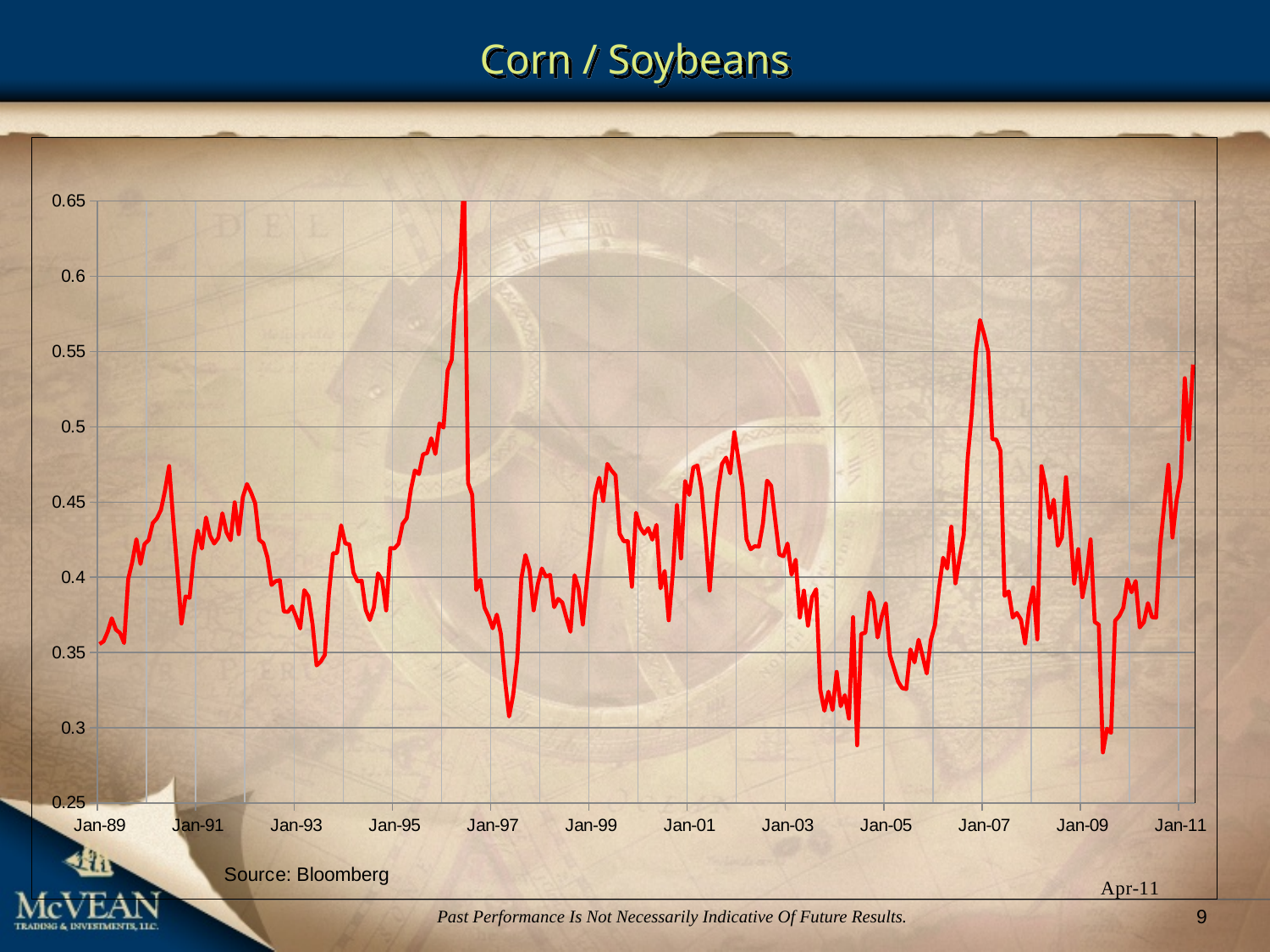
Does the line generally rise or fall between Jan-09 and Jan-11? rise How many year labels are shown on the x axis? 12 Is the peak value reached around Jan-07 greater or less than 0.55? greater How many lines (series) are plotted on the chart? 1 What is the title of the chart? Corn / Soybeans Is the peak value reached around 1996 greater or less than 0.6? greater What kind of chart is shown on the slide? line chart What source is cited for the chart data? Bloomberg Is the lowest value reached around 2009 greater or less than 0.3? less Which is larger, the value at Jan-11 or the value at Jan-89? Jan-11